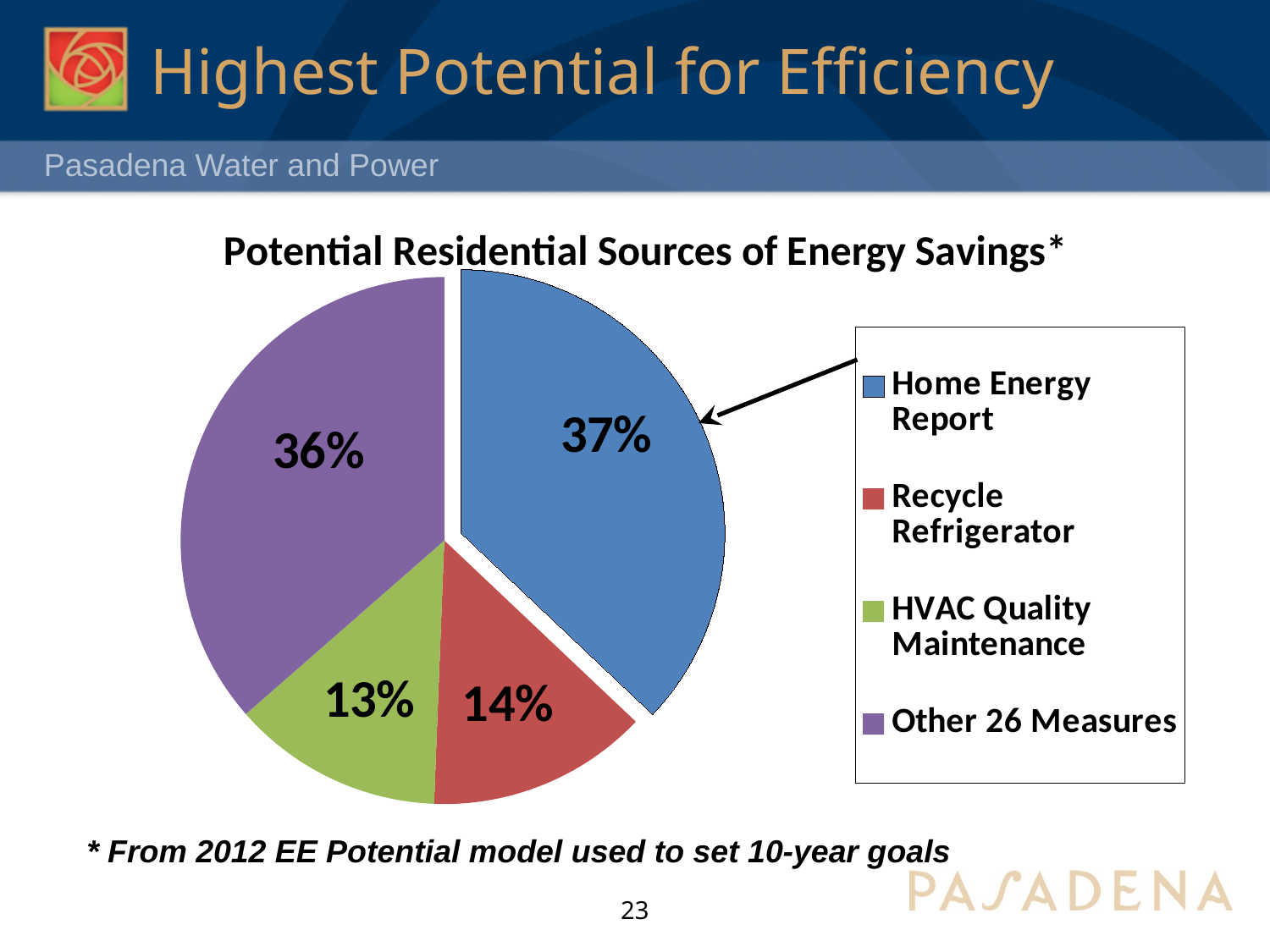
What kind of chart is shown on the slide? pie chart What colour is the slice for Other 26 Measures? purple What is the value shown for Other 26 Measures? 36% What is the value shown for HVAC Quality Maintenance? 13% Which category has the smallest slice of the pie? HVAC Quality Maintenance What is the value shown for Recycle Refrigerator? 14% Which is larger, the share for Recycle Refrigerator or the share for HVAC Quality Maintenance? Recycle Refrigerator What is the title of the chart? Potential Residential Sources of Energy Savings* Which category has the largest slice of the pie? Home Energy Report What is the difference between the Home Energy Report share and the Other 26 Measures share? 1% What share of the pie does Home Energy Report account for? 37% How many categories does the legend list? 4